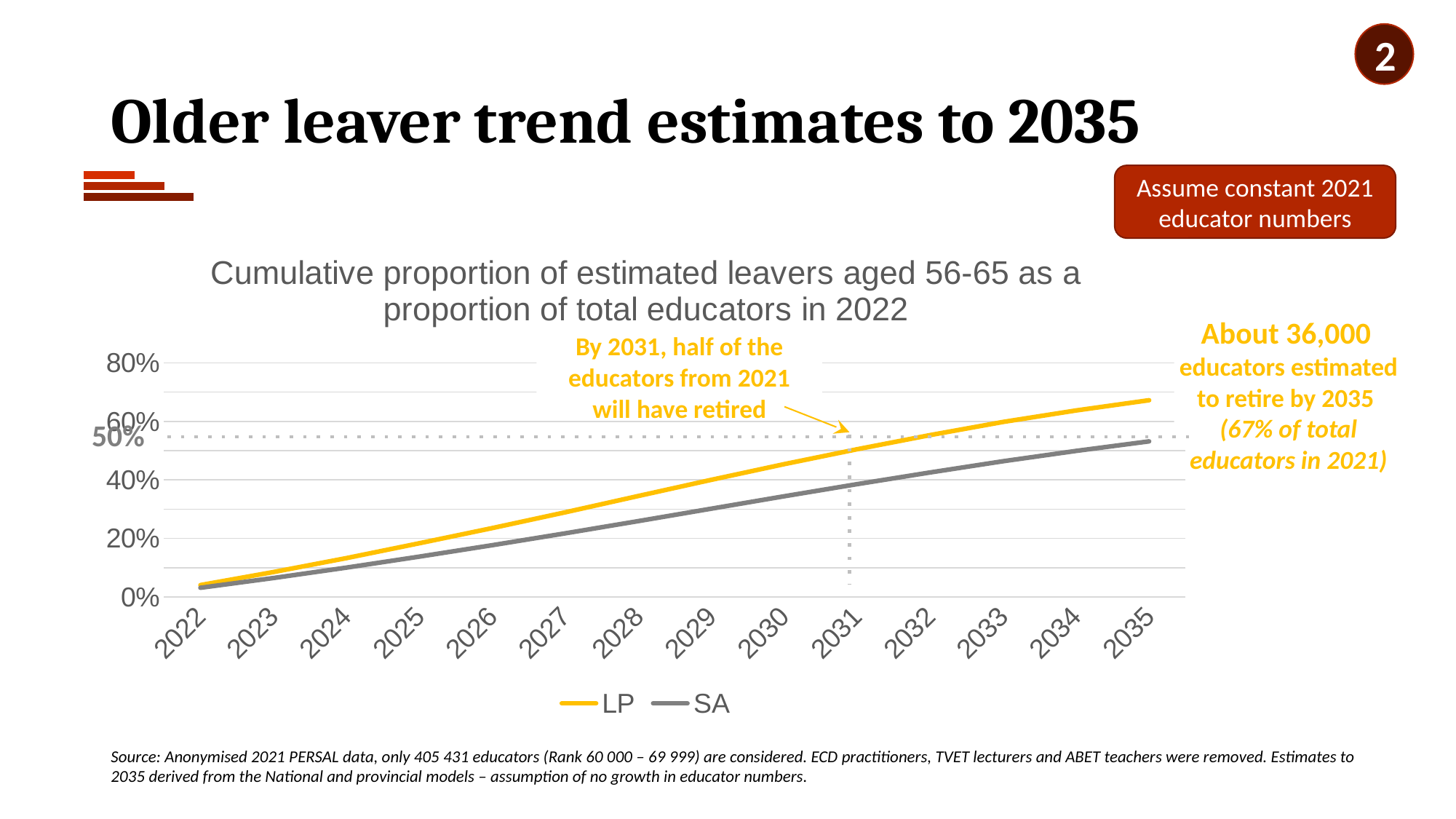
Do the values for LP rise or fall from 2022 to 2035? rise How many years are shown along the x axis? 14 Is the value for LP in 2035 greater or less than 60%? greater In which year does the LP series reach its highest value? 2035 Is the value for LP in 2022 greater or less than 20%? less How many series does the legend list? 2 What kind of chart is shown on the slide? line chart Is the value for SA in 2035 greater or less than 60%? less Which series is drawn in yellow? LP In 2035, which series has the higher value, LP or SA? LP Do the values for SA rise or fall from 2022 to 2035? rise